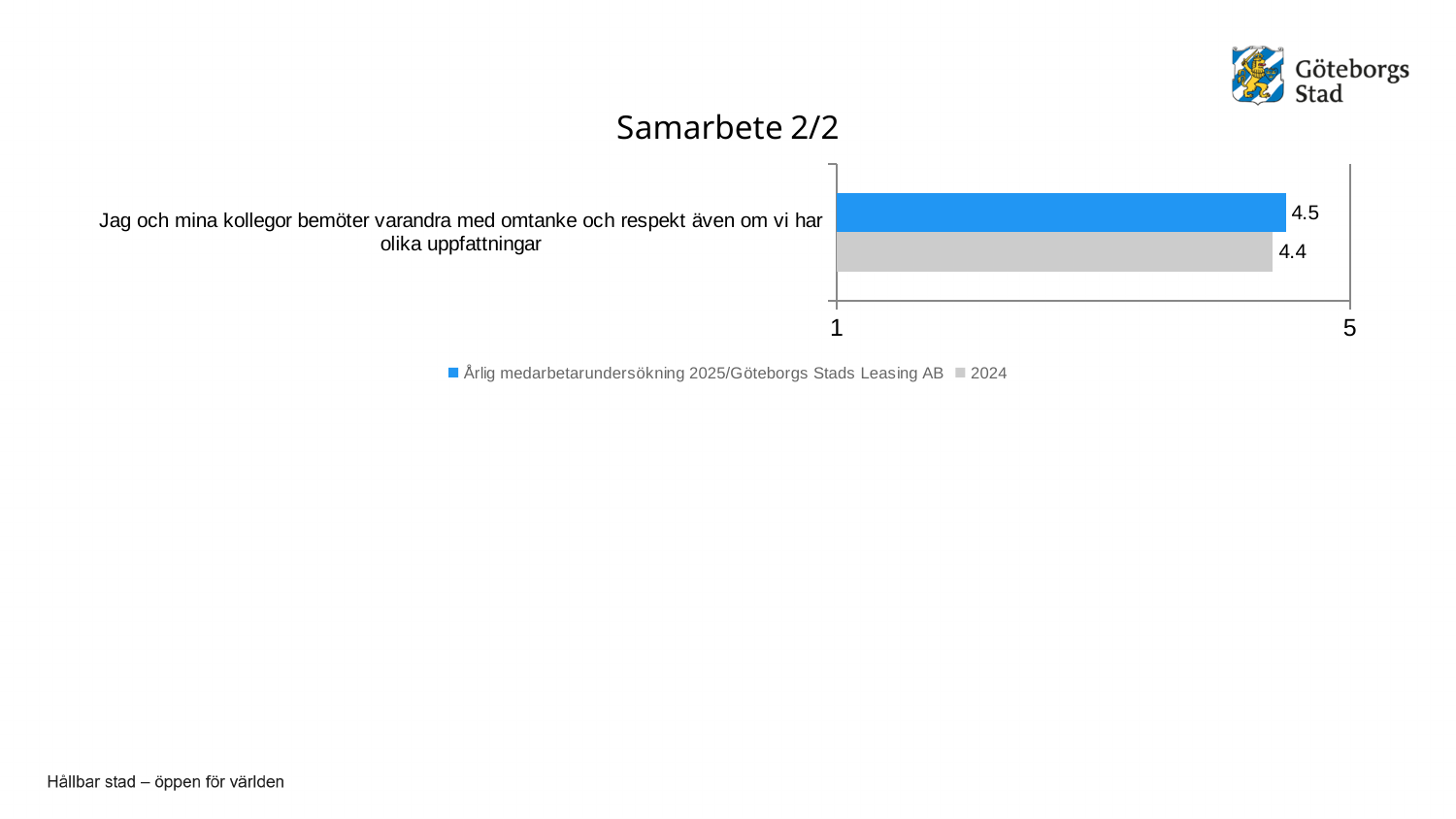
What is the maximum value shown on the x axis of the chart? 5 What is the difference between the 2025 value (4.5) and the 2024 value (4.4) for the statement shown? 0.1 What is the value for the series '2024' for the statement 'Jag och mina kollegor bemöter varandra med omtanke och respekt även om vi har olika uppfattningar'? 4.4 How many series does the legend list? 2 Which series has the higher value for the statement shown: 'Årlig medarbetarundersökning 2025/Göteborgs Stads Leasing AB' or '2024'? Årlig medarbetarundersökning 2025/Göteborgs Stads Leasing AB What kind of chart is shown on the slide? Bar chart What is the title of the chart on the slide? Samarbete 2/2 What colour is the bar for the series '2024'? Grey How many statements (categories) are plotted in the chart? 1 What is the value for the series 'Årlig medarbetarundersökning 2025/Göteborgs Stads Leasing AB' for the statement 'Jag och mina kollegor bemöter varandra med omtanke och respekt även om vi har olika uppfattningar'? 4.5 Is the value for the series '2024' greater or less than 5? less